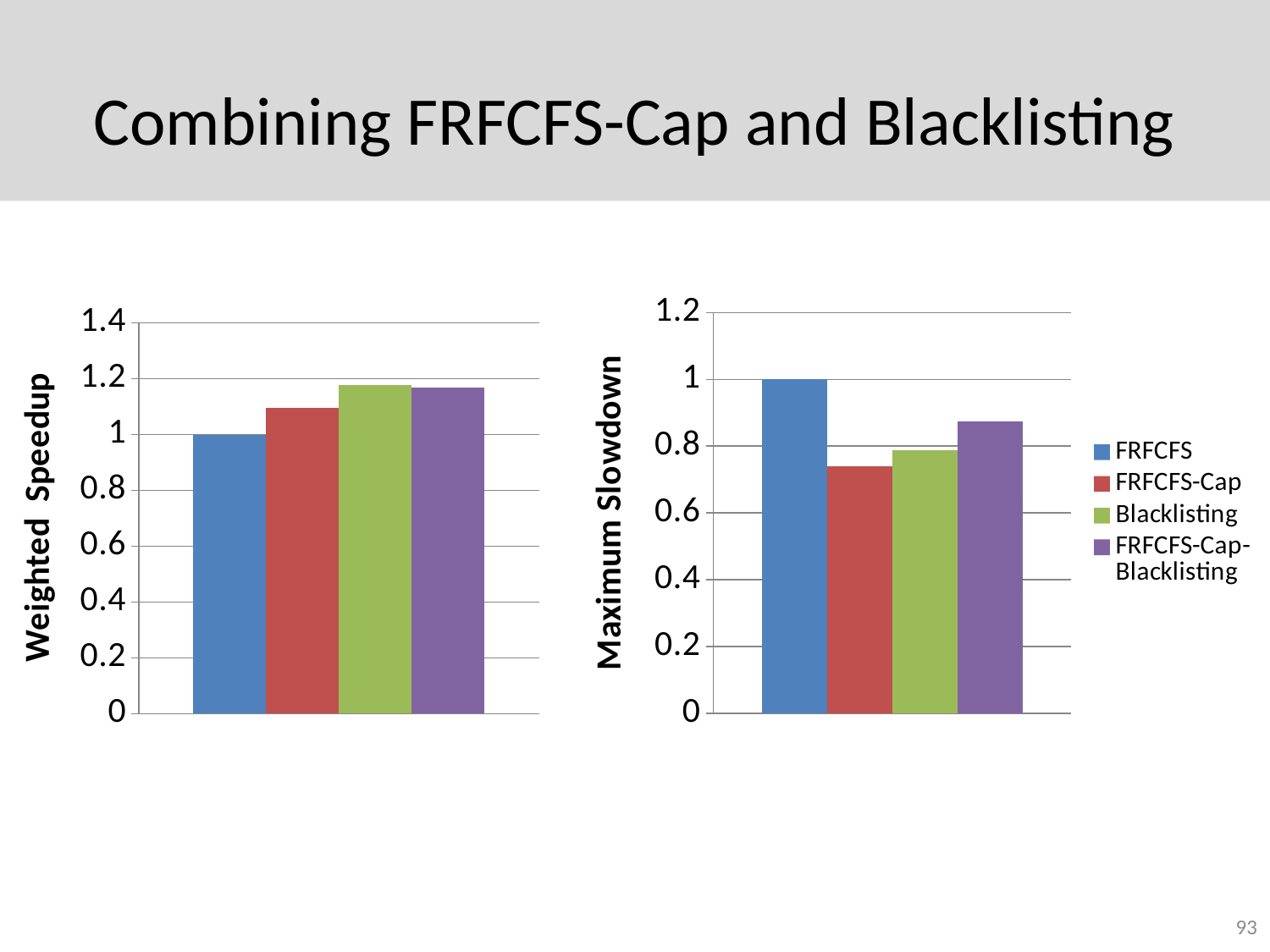
In the Weighted Speedup chart, which series has the lowest value? FRFCFS In the Maximum Slowdown chart, which series has the highest value? FRFCFS In the Weighted Speedup chart, is the value for Blacklisting greater or less than 1.2? less In the Weighted Speedup chart, what is the value for FRFCFS? 1 How many series does the legend list? 4 In the Maximum Slowdown chart, is the value for FRFCFS-Cap greater or less than 0.8? less In the Maximum Slowdown chart, is the value for FRFCFS-Cap-Blacklisting greater or less than 0.8? greater In the Weighted Speedup chart, which is larger, FRFCFS or Blacklisting? Blacklisting What type of chart is the Weighted Speedup chart on the left? bar chart In the Maximum Slowdown chart, which is larger, FRFCFS-Cap or FRFCFS-Cap-Blacklisting? FRFCFS-Cap-Blacklisting In the Maximum Slowdown chart, what is the value for FRFCFS? 1